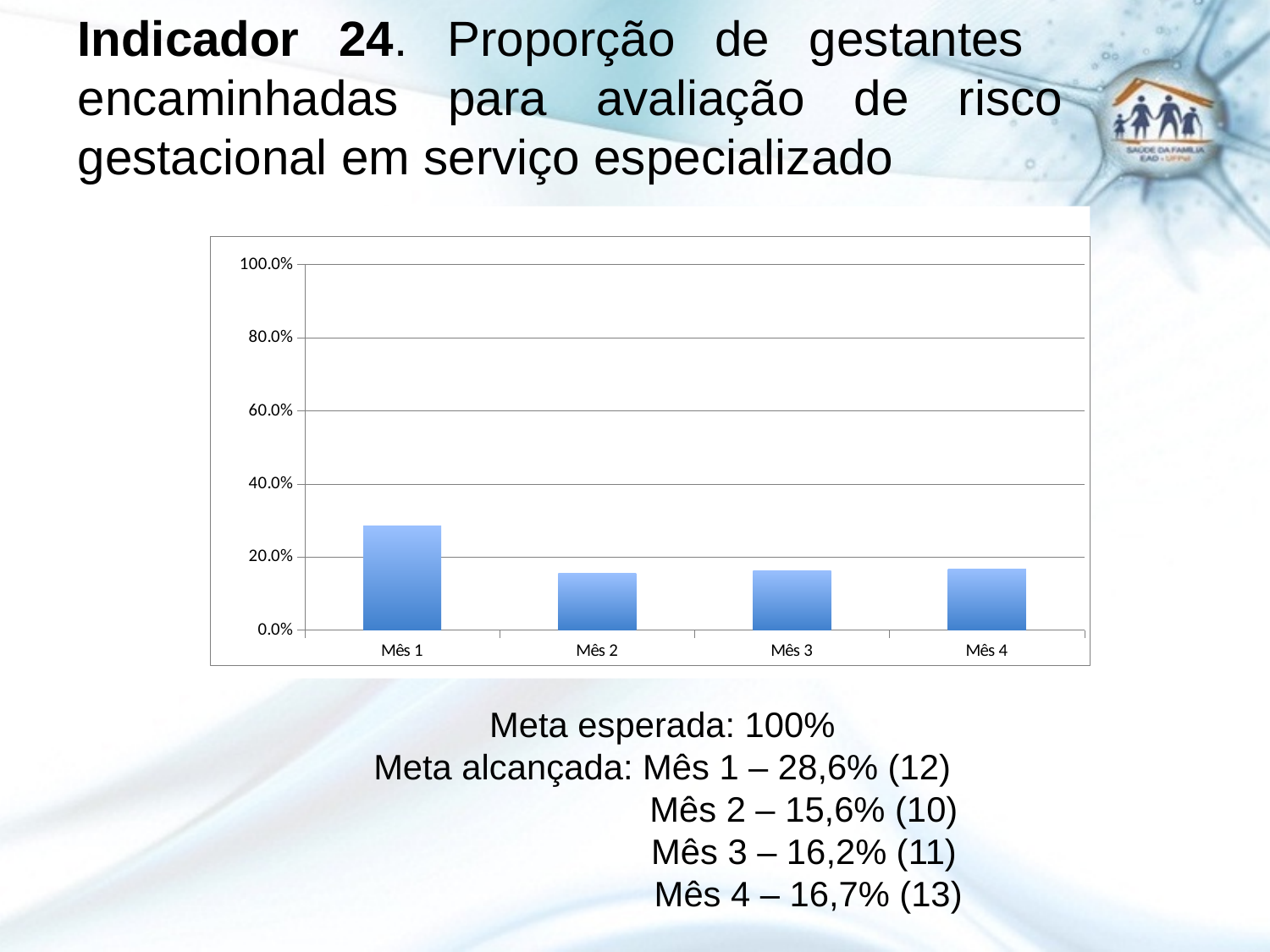
What is the highest value shown on the chart's vertical axis? 100.0% What is the difference between the values for Mês 1 (28,6%) and Mês 2 (15,6%)? 13,0 percentage points Which is larger, the value for Mês 1 or the value for Mês 4? Mês 1 What is the value for Mês 3 as printed on the slide? 16,2% What is the value for Mês 4 as printed on the slide? 16,7% Which month has the highest proportion in the chart? Mês 1 What is the value for Mês 1 as printed on the slide? 28,6% Is the value for Mês 2 greater or less than 20.0%? less Is the value for Mês 1 greater or less than 20.0%? greater How many months (categories) are plotted in the chart? 4 Which month has the lowest proportion according to the values printed on the slide? Mês 2 What type of chart is shown on the slide? bar chart